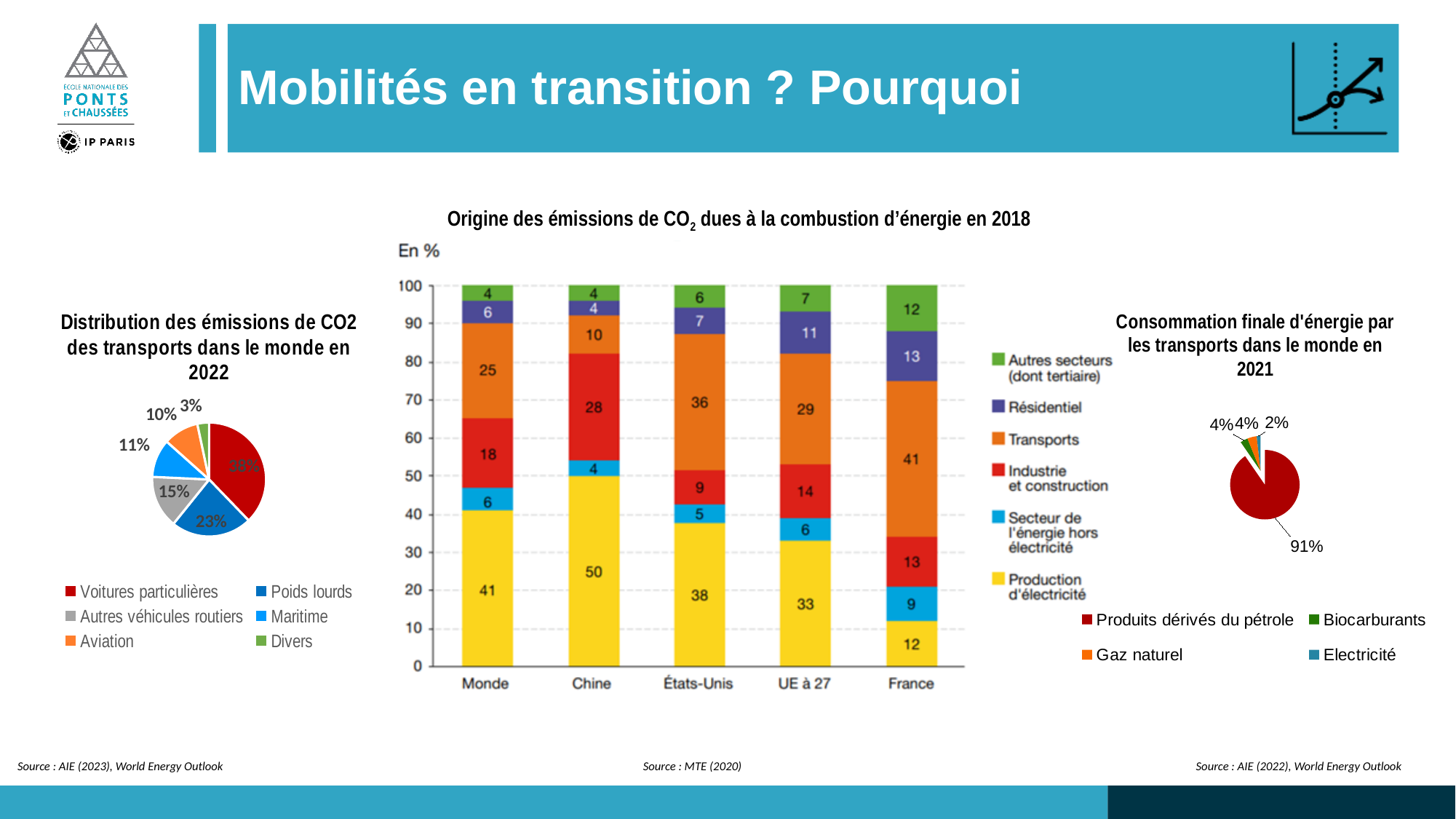
What type of chart is the center chart 'Origine des émissions de CO2 dues à la combustion d'énergie en 2018'? Stacked bar chart In the center chart 'Origine des émissions de CO2 dues à la combustion d'énergie en 2018', is the Industrie et construction value larger for Chine or for États-Unis? Chine In the left pie chart 'Distribution des émissions de CO2 des transports dans le monde en 2022', what share is Voitures particulières? 38% In the center chart 'Origine des émissions de CO2 dues à la combustion d'énergie en 2018', which country or region has the highest value for Production d'électricité? Chine In the center chart 'Origine des émissions de CO2 dues à la combustion d'énergie en 2018', what is the value of Transports for France? 41 How many series does the legend of the center chart 'Origine des émissions de CO2 dues à la combustion d'énergie en 2018' list? 6 In the right pie chart 'Consommation finale d'énergie par les transports dans le monde en 2021', what share is Electricité? 2% In the center chart 'Origine des émissions de CO2 dues à la combustion d'énergie en 2018', what is the difference between the Transports values for États-Unis and Monde? 11 In the left pie chart 'Distribution des émissions de CO2 des transports dans le monde en 2022', what is the difference between the shares of Poids lourds and Maritime? 12% In the left pie chart 'Distribution des émissions de CO2 des transports dans le monde en 2022', which category has the smallest share? Divers In the right pie chart 'Consommation finale d'énergie par les transports dans le monde en 2021', what share is Produits dérivés du pétrole? 91% How many categories does the legend of the left pie chart 'Distribution des émissions de CO2 des transports dans le monde en 2022' list? 6